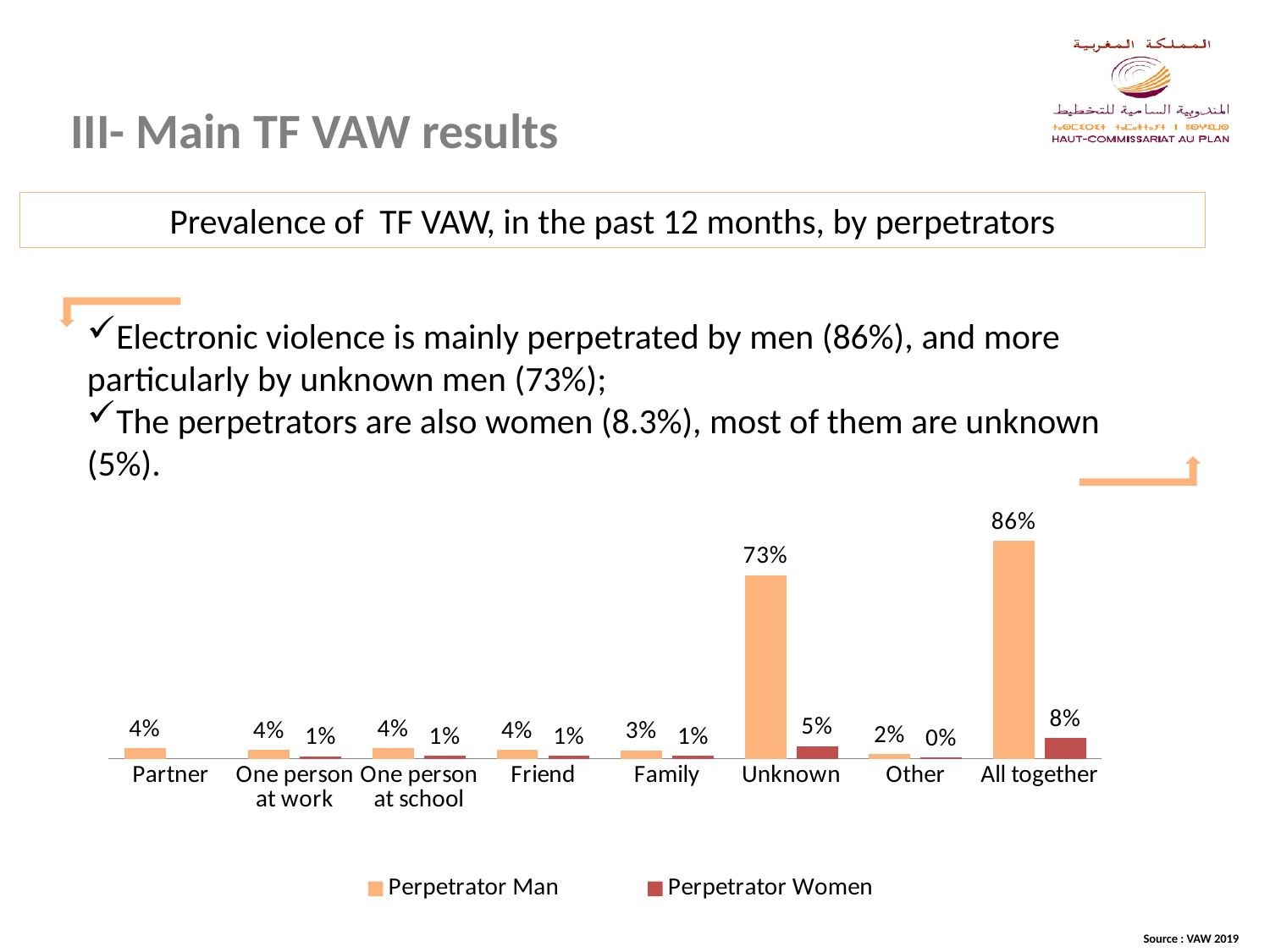
What is the Perpetrator Women value for Other? 0% What kind of chart is shown on the slide? Bar chart What is the Perpetrator Women value for All together? 8% Which series is shown in orange in the legend? Perpetrator Man Which category has the highest Perpetrator Man value? All together Which is larger, the Perpetrator Man value for Unknown or the Perpetrator Man value for Friend? Unknown How many categories are shown on the x axis? 8 What is the Perpetrator Man value for Family? 3% What is the Perpetrator Man value for Unknown? 73% Which category has the lowest Perpetrator Women value? Other What is the difference between the Perpetrator Man and Perpetrator Women values for Unknown? 68% How many series does the legend list? 2